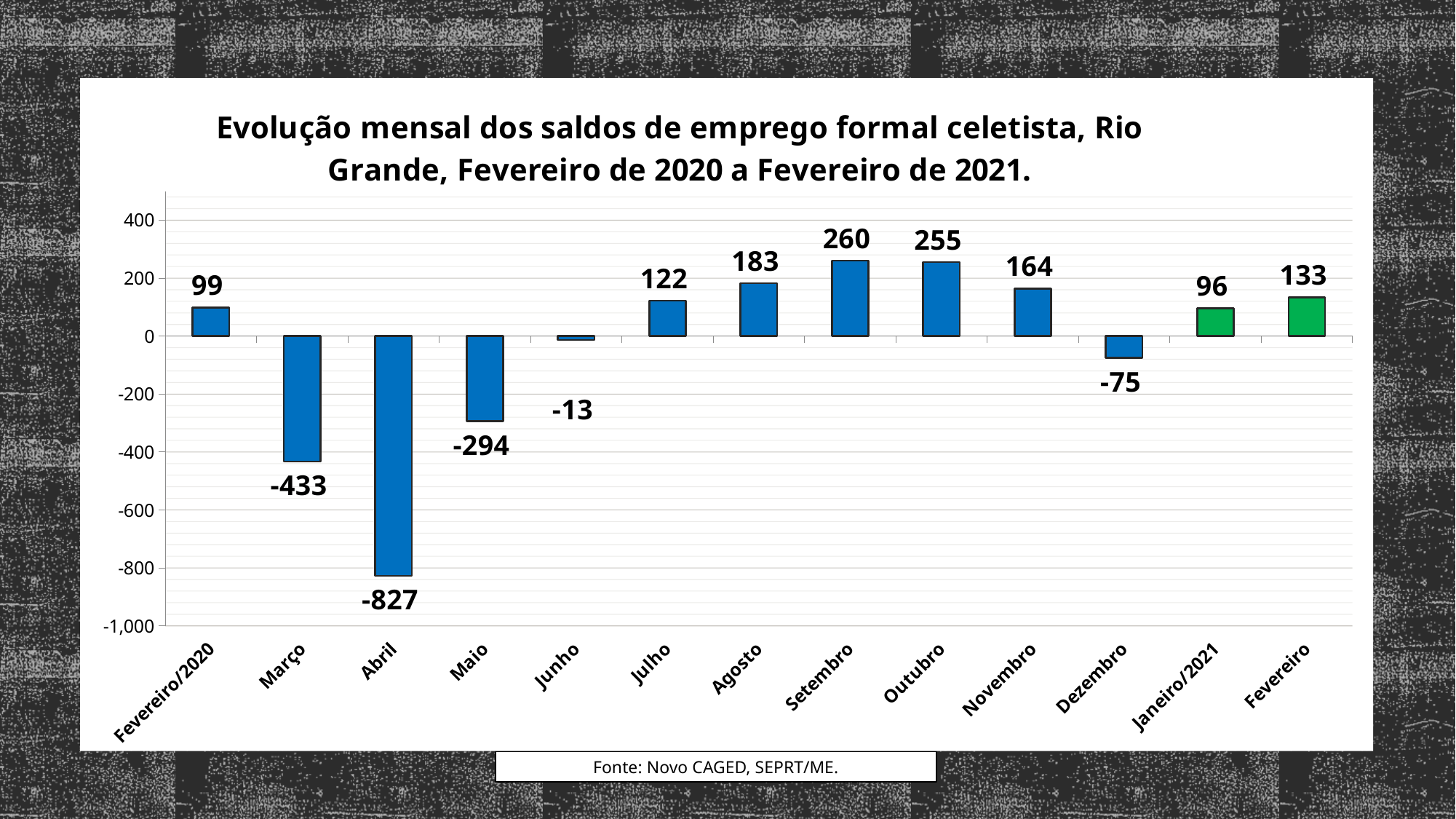
What kind of chart is this? Bar chart Which is larger, the value for Julho or the value for Novembro? Novembro What is the difference between the values for Setembro and Outubro? 5 Which month has the lowest value? Abril Which month has the highest value? Setembro What is the value for Fevereiro/2020? 99 What is the difference between the values for Março and Maio? 139 What is the value for Setembro? 260 How many months are shown on the x axis? 13 What is the value for Dezembro? -75 What is the source cited below the chart? Novo CAGED, SEPRT/ME. What is the value for Abril? -827